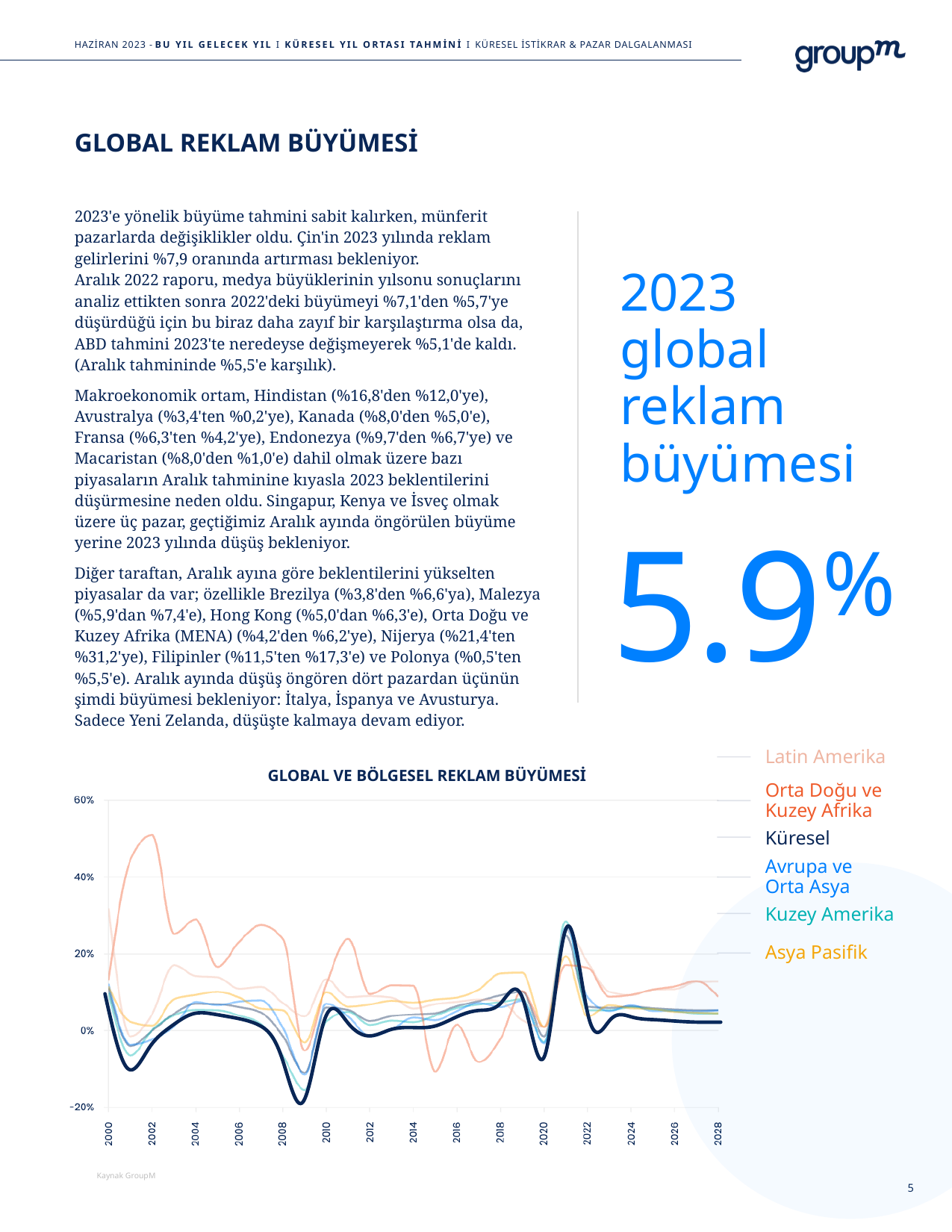
In the "GLOBAL VE BÖLGESEL REKLAM BÜYÜMESİ" chart, does the Küresel line rise or fall from 2021 to 2023? Fall What kind of chart is shown under the title "GLOBAL VE BÖLGESEL REKLAM BÜYÜMESİ"? Line chart In the "GLOBAL VE BÖLGESEL REKLAM BÜYÜMESİ" chart, which series reaches the highest value anywhere on the chart? Latin Amerika In the "GLOBAL VE BÖLGESEL REKLAM BÜYÜMESİ" chart, is the value for Küresel in 2021 greater or less than 20%? greater How many year labels are shown on the x axis of the "GLOBAL VE BÖLGESEL REKLAM BÜYÜMESİ" chart? 15 How many series does the legend of the "GLOBAL VE BÖLGESEL REKLAM BÜYÜMESİ" chart list? 6 In the "GLOBAL VE BÖLGESEL REKLAM BÜYÜMESİ" chart, does the Küresel line rise or fall from 2008 to 2009? Fall Which legend entry of the chart is shown in dark navy, the thickest line? Küresel In the "GLOBAL VE BÖLGESEL REKLAM BÜYÜMESİ" chart, is the value for Latin Amerika in 2002 greater or less than 40%? greater In the "GLOBAL VE BÖLGESEL REKLAM BÜYÜMESİ" chart, is the value for Küresel in 2009 greater or less than 0%? less What is the title of the chart at the bottom of the slide? GLOBAL VE BÖLGESEL REKLAM BÜYÜMESİ In the "GLOBAL VE BÖLGESEL REKLAM BÜYÜMESİ" chart, which is larger in 2002: the value for Latin Amerika or the value for Küresel? Latin Amerika